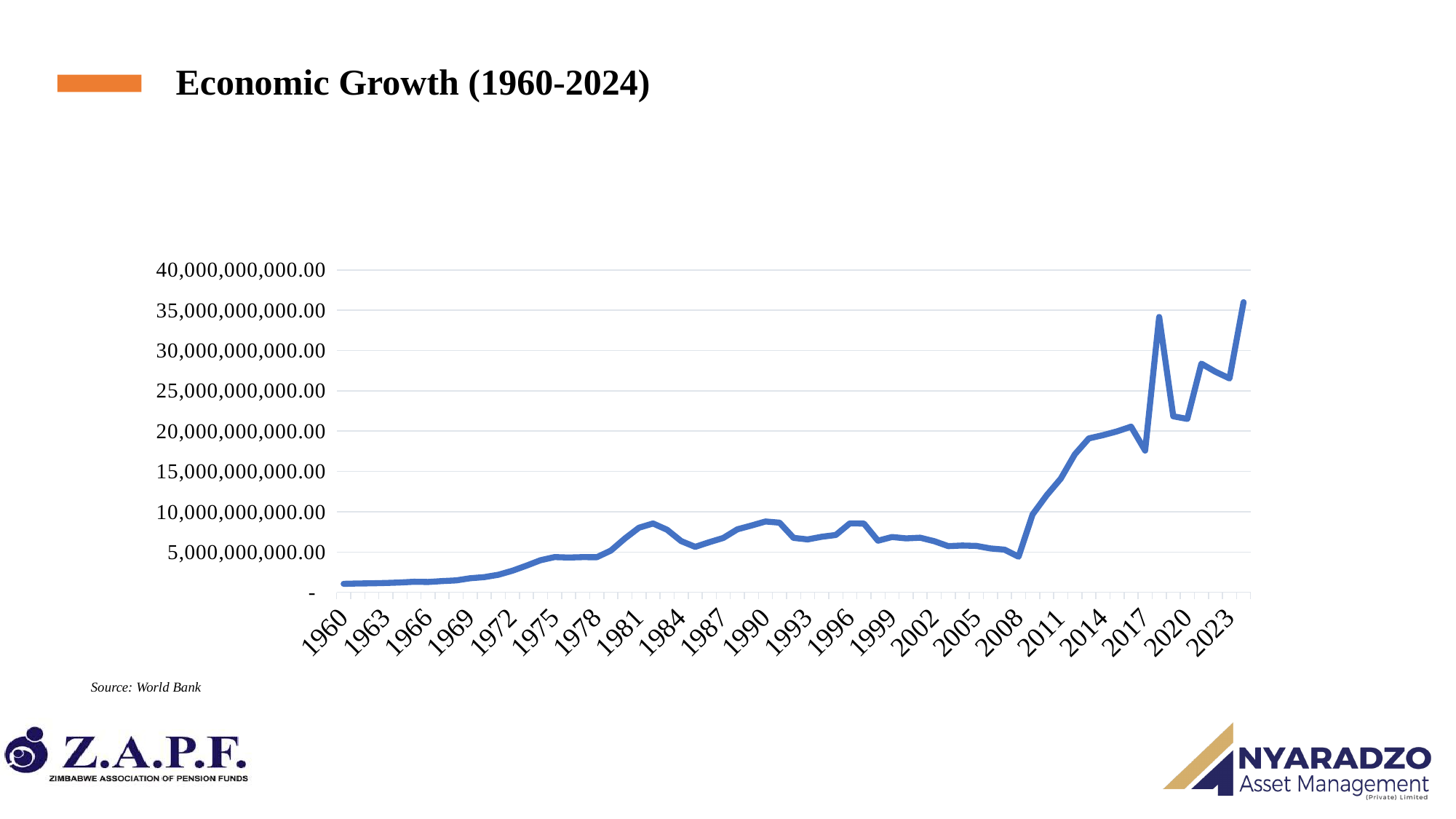
Which is larger, the value for 2023 or the value for 1960? 2023 Which year has the lowest value on the chart? 1960 Is the value for 2017 greater or less than 20,000,000,000.00? less What kind of chart is shown on the slide? line chart What source is cited for the chart data? World Bank What is the title of the chart? Economic Growth (1960-2024) Which is larger, the value for 1990 or the value for 2008? 1990 Is the value for 1960 greater or less than 5,000,000,000.00? less How many year labels are shown on the x axis? 22 Overall, do the values rise or fall from 1960 to 2024? rise Is the value for 1981 greater or less than 5,000,000,000.00? greater